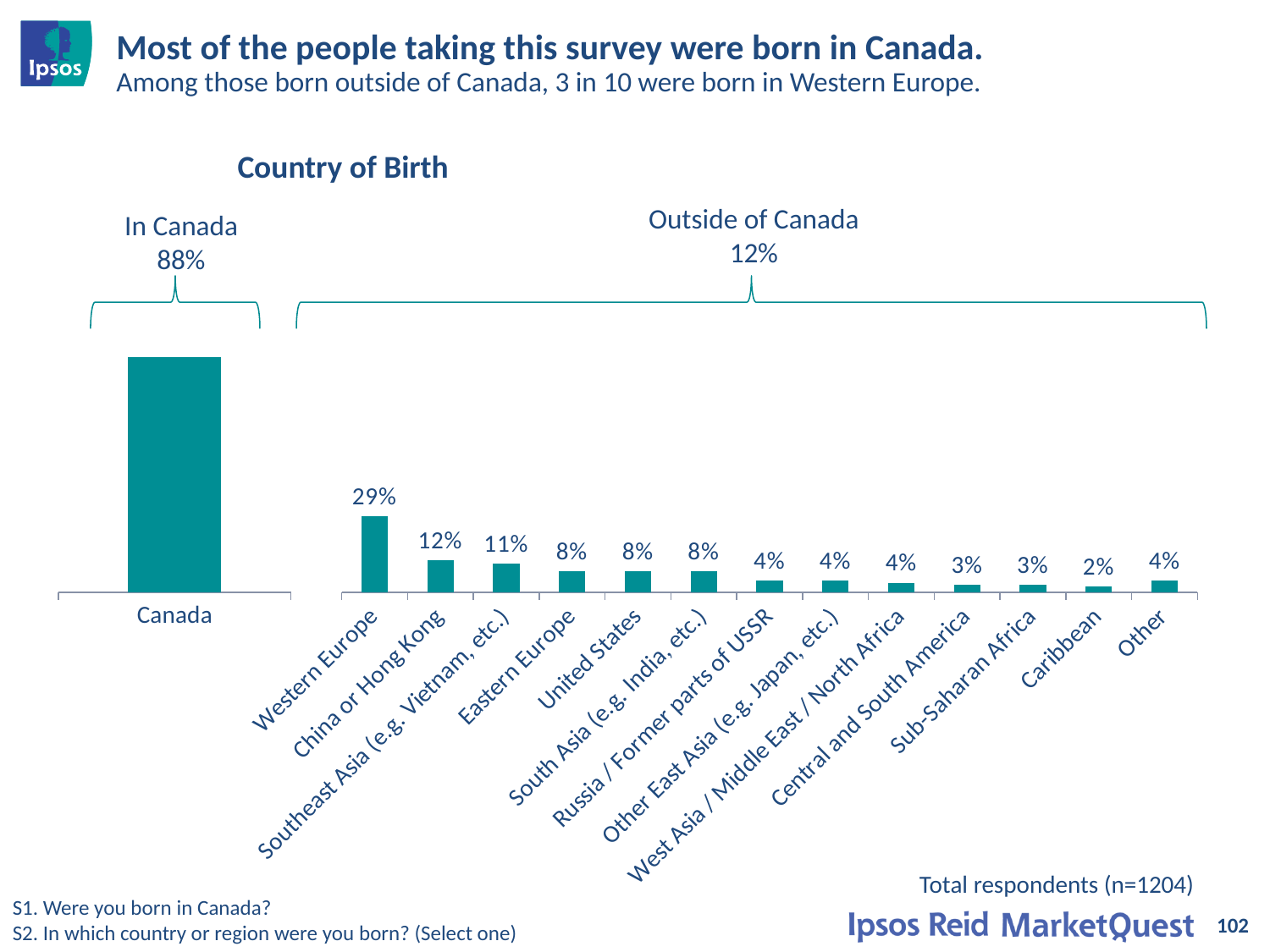
What percentage of respondents were born outside of Canada, according to the bracket label on the chart? 12% In the Country of Birth chart, which is larger: the value for Southeast Asia (e.g. Vietnam, etc.) or the value for Eastern Europe? Southeast Asia (e.g. Vietnam, etc.) What percentage of respondents were born in Canada, as shown on the slide? 88% How many regions outside of Canada are plotted as bars in the Country of Birth chart? 13 Among the regions outside of Canada, which has the lowest value in the Country of Birth chart? Caribbean What is the difference between the values for Western Europe and China or Hong Kong in the Country of Birth chart? 17% What kind of chart is used to show Country of Birth on this slide? Bar chart What percentage of respondents were born in Western Europe, according to the Country of Birth chart? 29% In the Country of Birth chart, what is the value for China or Hong Kong? 12% Among the regions outside of Canada, which has the highest value in the Country of Birth chart? Western Europe What value is shown for Caribbean in the Country of Birth chart? 2% What is the value for Sub-Saharan Africa in the Country of Birth chart? 3%